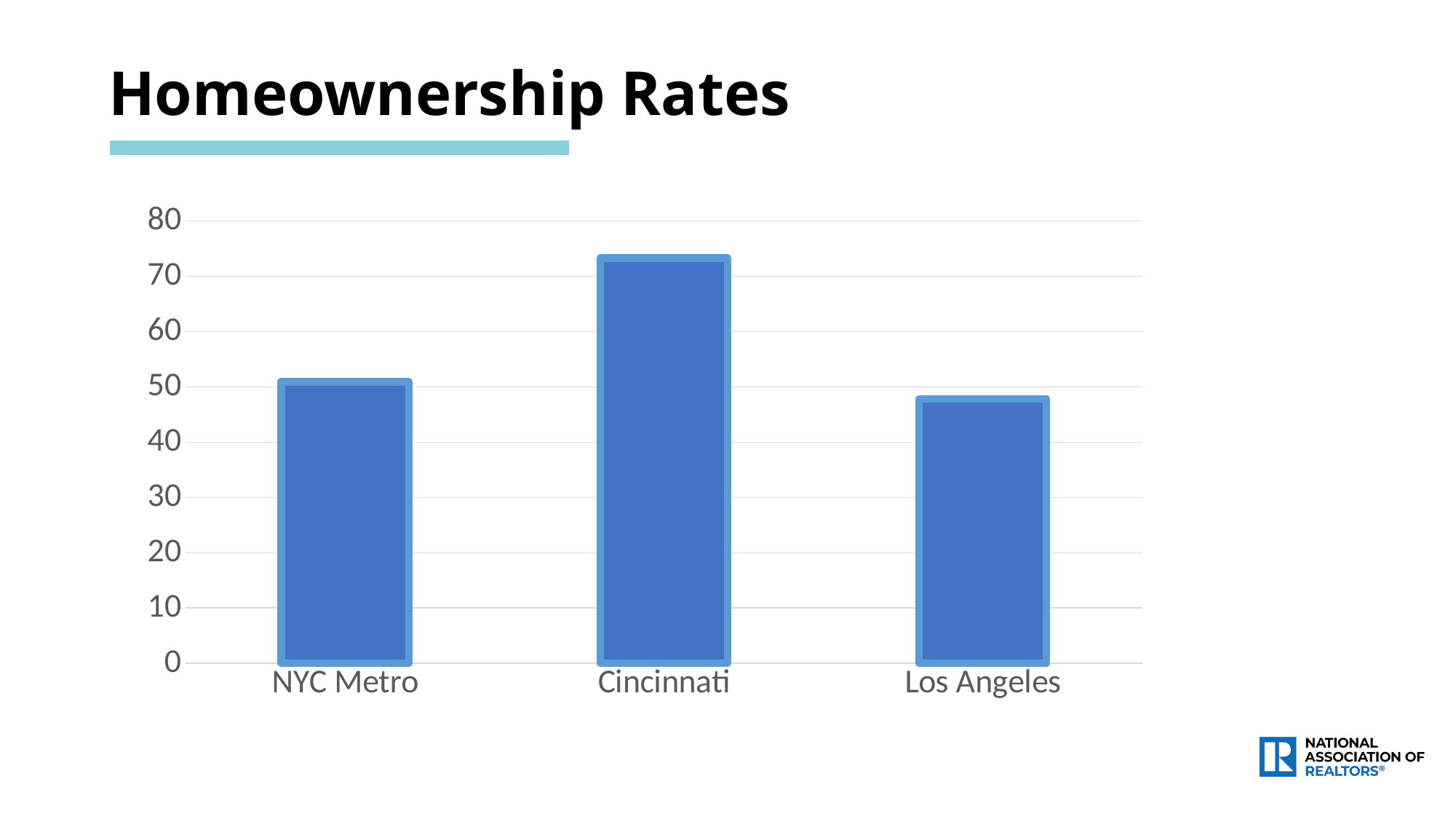
What kind of chart is shown on the slide? bar chart How many categories are plotted in the chart? 3 Is the value for Los Angeles greater or less than 40? greater Is the value for Cincinnati greater or less than 80? less What is the title of the slide? Homeownership Rates What is the highest value shown on the vertical axis? 80 Which is larger, the value for NYC Metro or the value for Los Angeles? NYC Metro Which category has the highest homeownership rate? Cincinnati Which is larger, the value for Cincinnati or the value for NYC Metro? Cincinnati Is the value for NYC Metro greater or less than 60? less Which category has the lowest homeownership rate? Los Angeles